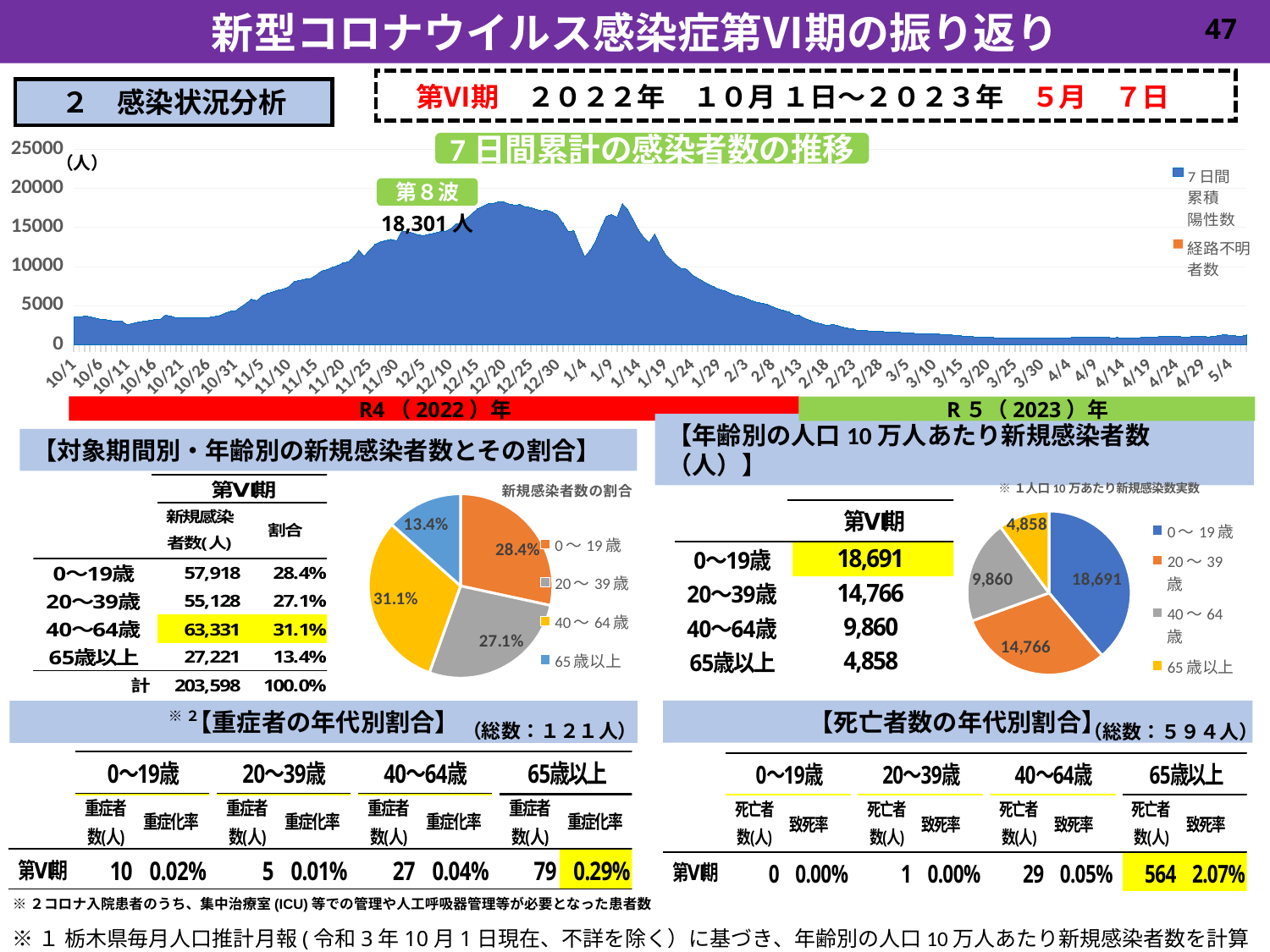
In the pie chart 年齢別の人口10万人あたり新規感染者数, what is the value for 20〜39歳? 14,766 In the pie chart 新規感染者数の割合, what share does 40〜64歳 have? 31.1% In the pie chart 新規感染者数の割合, which age group has the smallest share? 65歳以上 In the pie chart 年齢別の人口10万人あたり新規感染者数, which age group has the highest value? 0〜19歳 What kind of chart is the 7日間累計の感染者数の推移 chart at the top of the slide? area chart How many series does the legend of the 7日間累計の感染者数の推移 chart list? 2 How many slices does the pie chart 新規感染者数の割合 have? 4 In the pie chart 年齢別の人口10万人あたり新規感染者数, what is the difference between the values for 0〜19歳 and 65歳以上? 13,833 In the area chart titled 7日間累計の感染者数の推移, what peak value is labeled at 第8波? 18,301人 In the 7日間累計の感染者数の推移 chart, is the value at 10/1 greater or less than 5000? less In the 7日間累計の感染者数の推移 chart, do the values rise or fall from 12/20 to 5/4? fall In the pie chart 新規感染者数の割合, which age group has the largest share? 40〜64歳